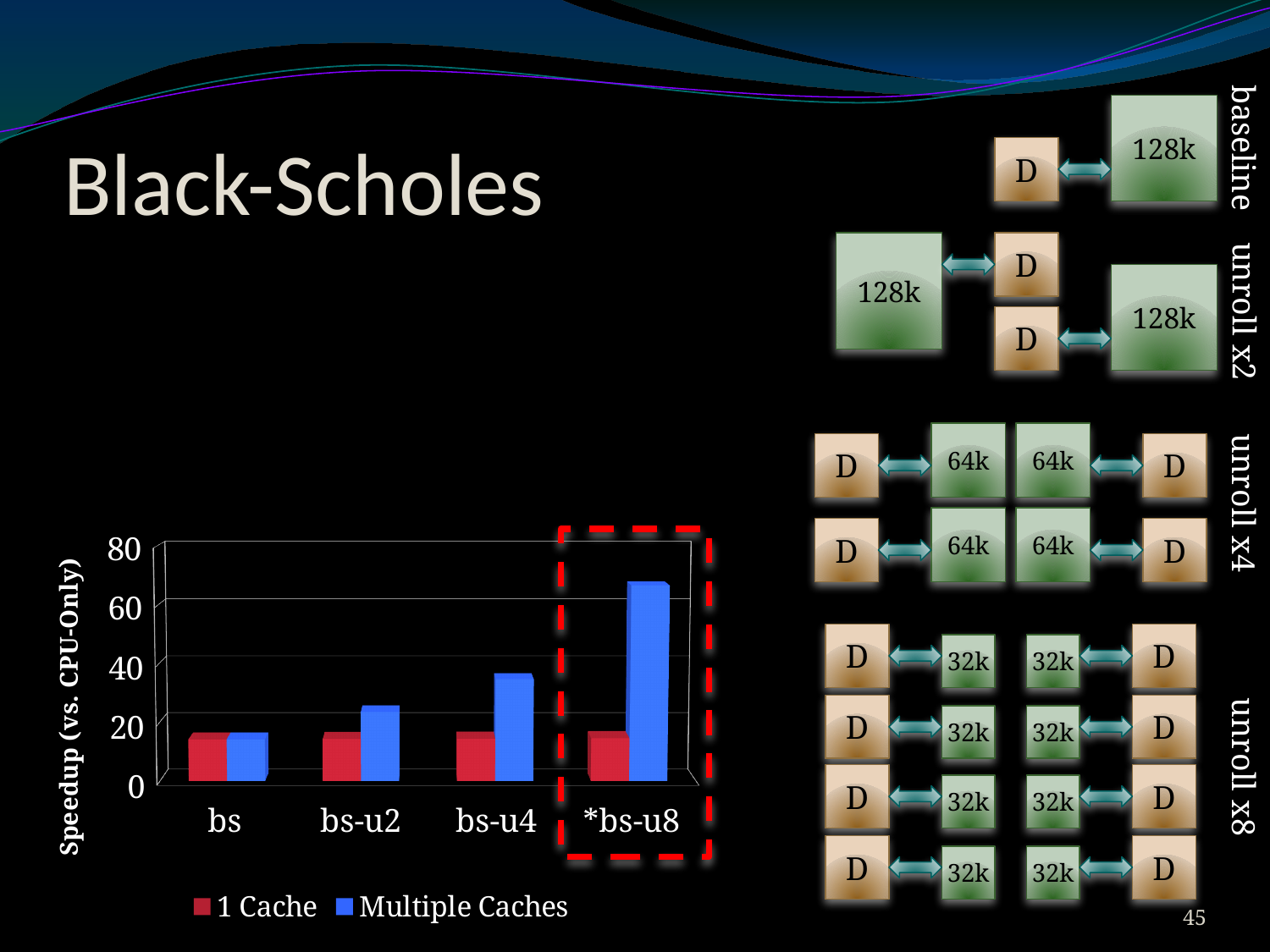
Which is larger, the Multiple Caches value for bs-u4 or for bs-u2? bs-u4 Is the 1 Cache value for bs greater or less than 20? less What kind of chart is shown on the slide? bar chart What is the title of the chart's vertical axis? Speedup (vs. CPU-Only) Is the Multiple Caches value for bs-u2 greater or less than 40? less How many categories are shown on the x axis of the chart? 4 Which category has the highest Multiple Caches speedup? *bs-u8 How many series does the chart's legend list? 2 Which category has the lowest Multiple Caches speedup? bs Do the Multiple Caches values rise or fall from bs to *bs-u8 along the x axis? rise Is the Multiple Caches value for *bs-u8 greater or less than 60? greater Which category on the chart is outlined with a red dashed box? *bs-u8